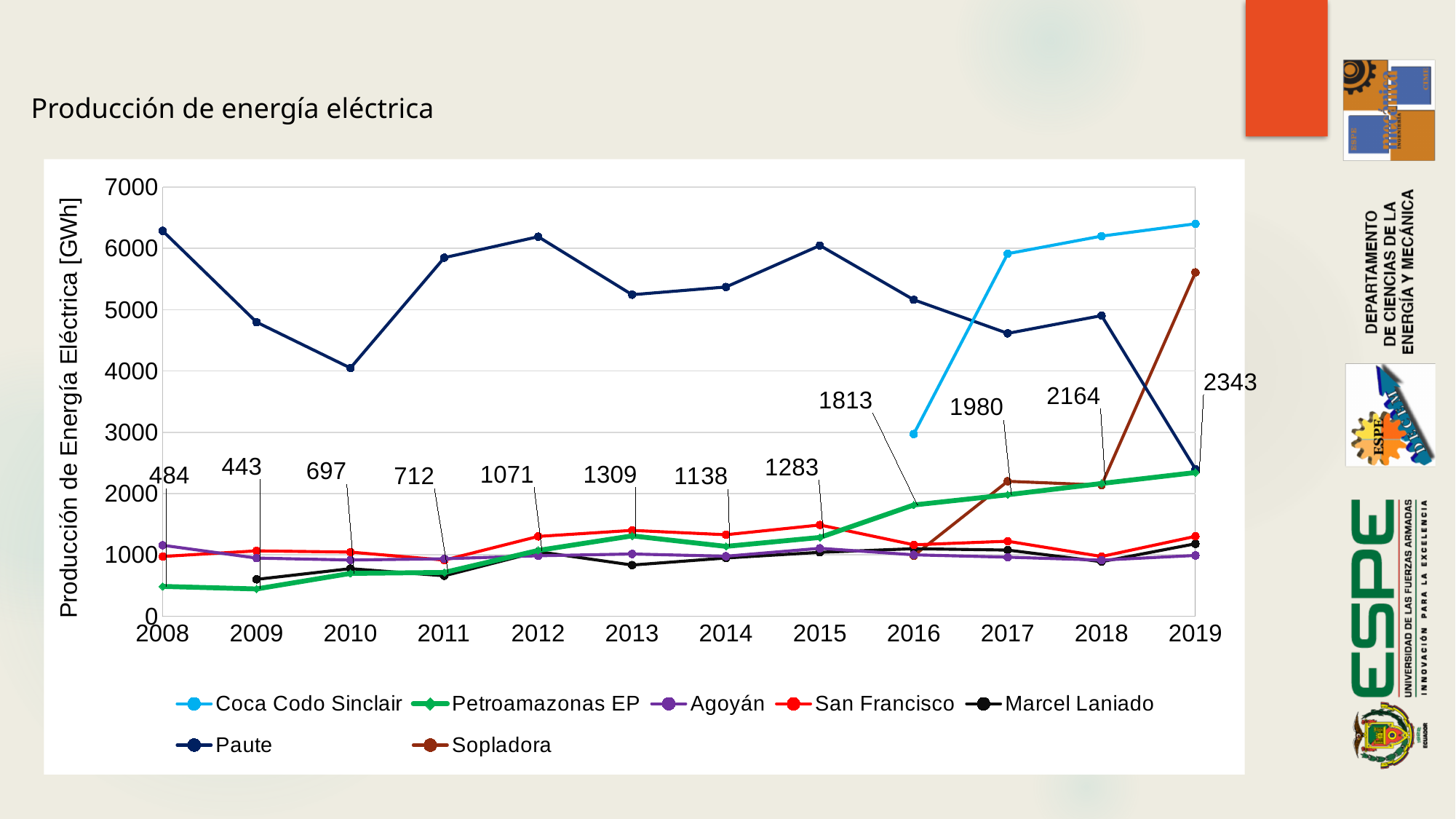
What is the difference between the Petroamazonas EP values in 2019 and 2018? 179 How many series does the legend list? 7 Is the value for Paute in 2008 greater or less than 6000? greater In which year is the labelled Petroamazonas EP value lowest? 2009 In which year is the labelled Petroamazonas EP value highest? 2019 What kind of chart is shown on the slide? Line chart How many years are shown on the x axis? 12 What is the value for Petroamazonas EP in 2013? 1309 What is the value for Petroamazonas EP in 2008? 484 Which series has the highest value in 2019? Coca Codo Sinclair What is the label of the y axis? Producción de Energía Eléctrica [GWh] What is the value for Petroamazonas EP in 2019? 2343